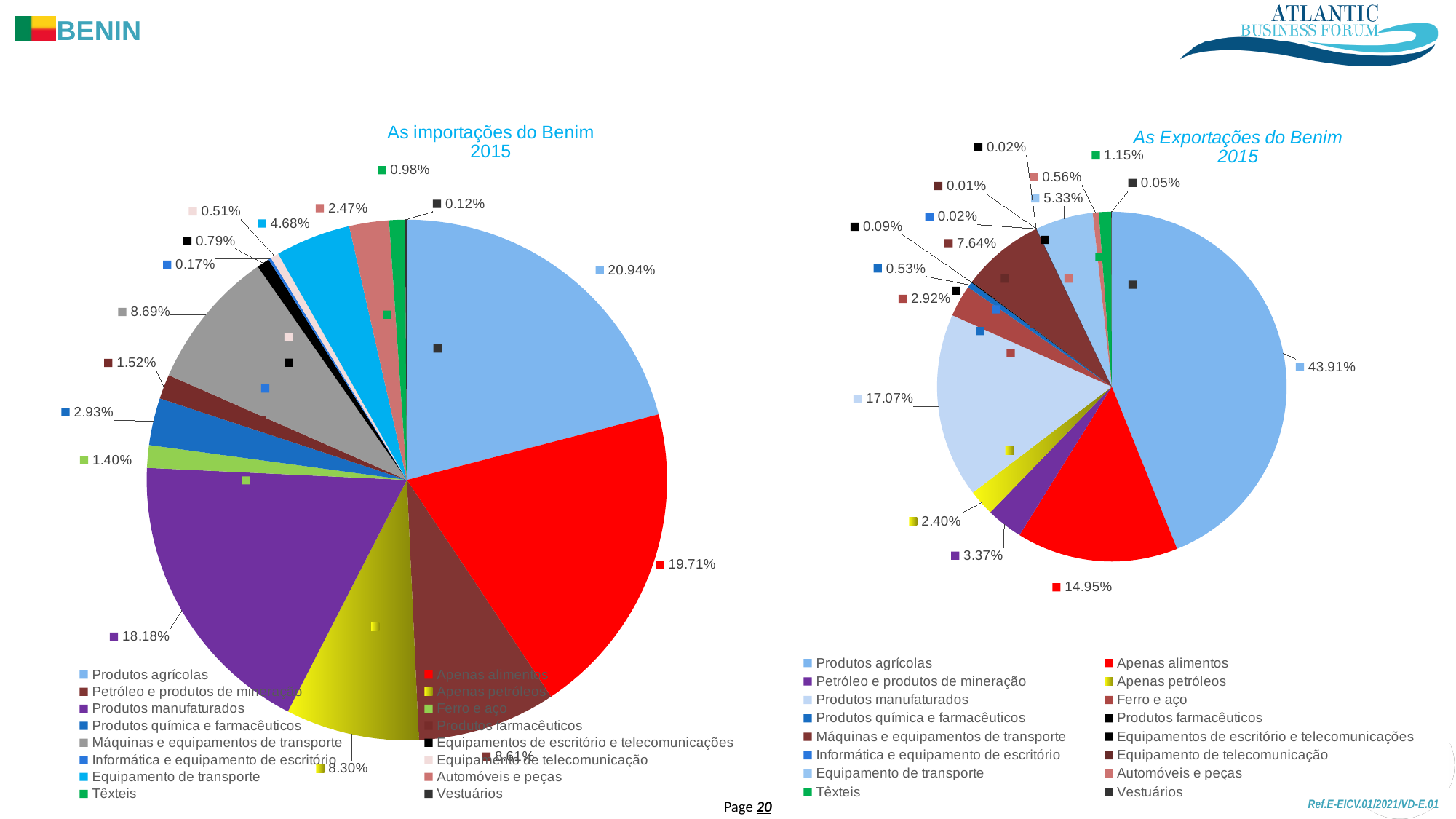
How many categories does the legend of 'As Exportações do Benim 2015' list? 16 In 'As Exportações do Benim 2015', what is the difference between the shares of Produtos agrícolas and Produtos manufaturados? 26.84% In 'As importações do Benim 2015', what is the share for Produtos manufaturados? 18.18% In 'As Exportações do Benim 2015', what is the share for Apenas alimentos? 14.95% In 'As importações do Benim 2015', what is the share for Produtos agrícolas? 20.94% What kind of chart is 'As importações do Benim 2015'? Pie chart In 'As Exportações do Benim 2015', which is larger: Produtos manufaturados or Apenas alimentos? Produtos manufaturados In 'As importações do Benim 2015', which category has the largest share? Produtos agrícolas In 'As importações do Benim 2015', what is the share for Apenas alimentos? 19.71% In 'As importações do Benim 2015', what is the difference between the shares of Produtos agrícolas and Apenas alimentos? 1.23% In 'As Exportações do Benim 2015', what is the share for Produtos manufaturados? 17.07% In 'As Exportações do Benim 2015', what is the share for Produtos agrícolas? 43.91%